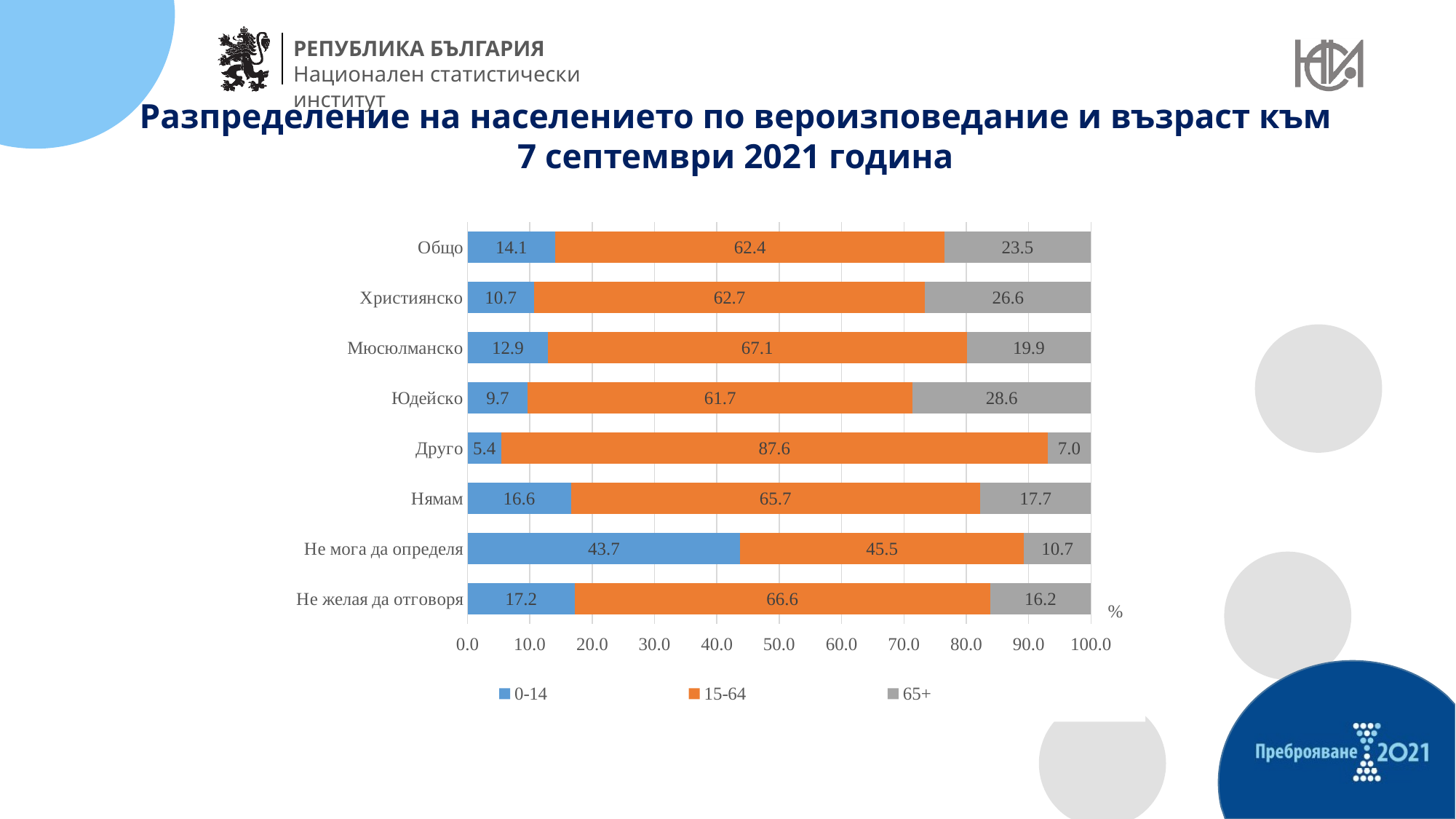
What is the value of the 65+ series for Юдейско? 28.6 What is the difference between the 65+ values for Християнско and Мюсюлманско? 6.7 Which series is shown in orange in the legend? 15-64 How many categories are shown on the y axis of the chart? 8 What is the value of the 0-14 series for Не мога да определя? 43.7 What is the value of the 15-64 series for Общо? 62.4 Which category has the highest value in the 15-64 series? Друго What kind of chart is shown on the slide? Stacked bar chart Which is larger: the 0-14 value for Нямам or the 0-14 value for Не желая да отговоря? Не желая да отговоря How many series does the legend list? 3 What is the total of the stacked bar for Мюсюлманско? 99.9 Which category has the lowest value in the 0-14 series? Друго